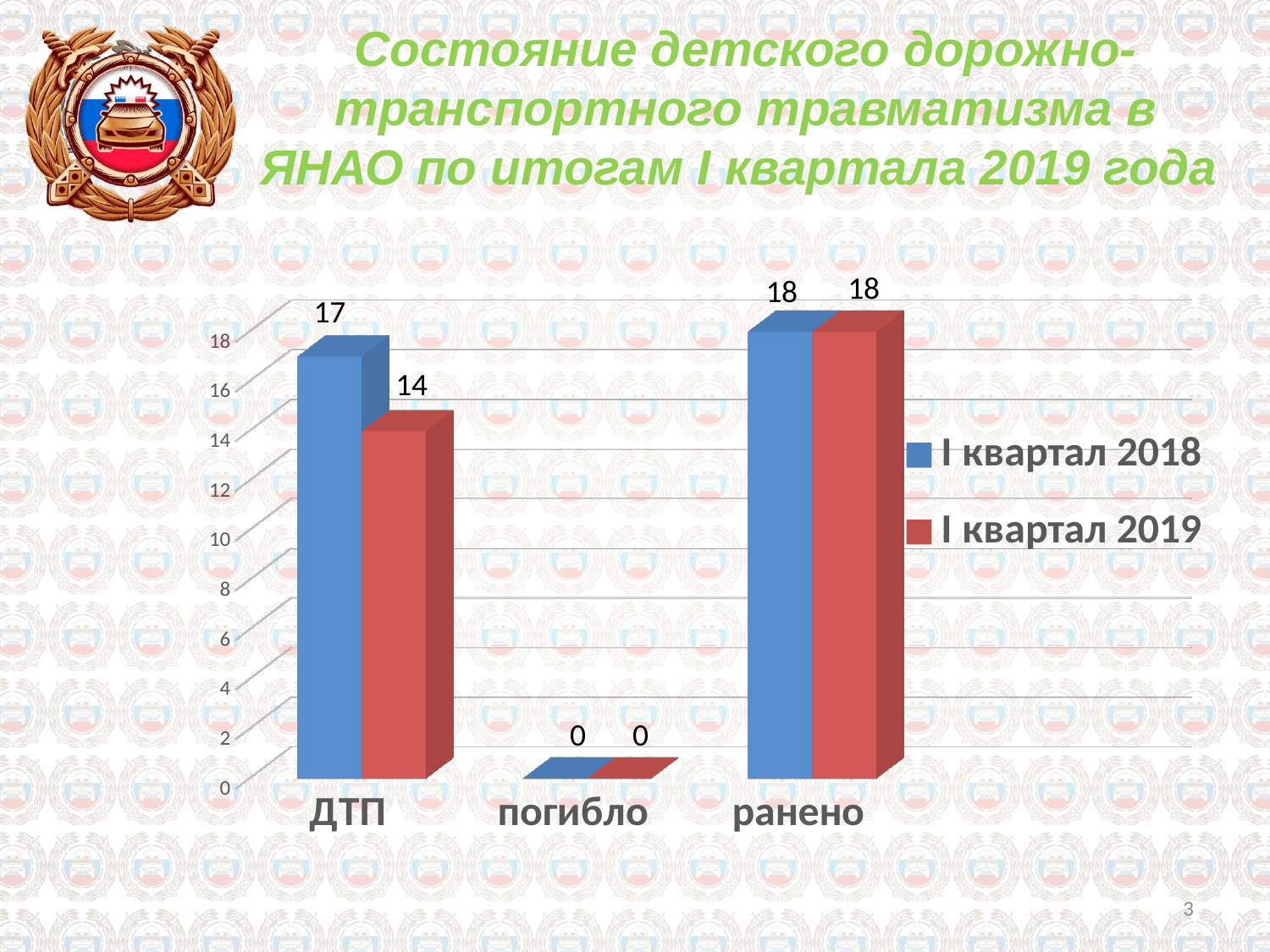
What is the value for погибло in I квартал 2018? 0 Which is larger for ДТП: I квартал 2018 or I квартал 2019? I квартал 2018 What is the value for ДТП in I квартал 2019? 14 What is the difference between the ДТП values for I квартал 2018 and I квартал 2019? 3 How many categories are shown on the x axis? 3 What is the value for ранено in I квартал 2019? 18 Which category has the highest value in I квартал 2018? ранено Which category has the lowest value in I квартал 2019? погибло Which colour represents I квартал 2019 in the legend? red What is the value for ДТП in I квартал 2018? 17 What kind of chart is shown on the slide? bar chart How many series does the legend list? 2